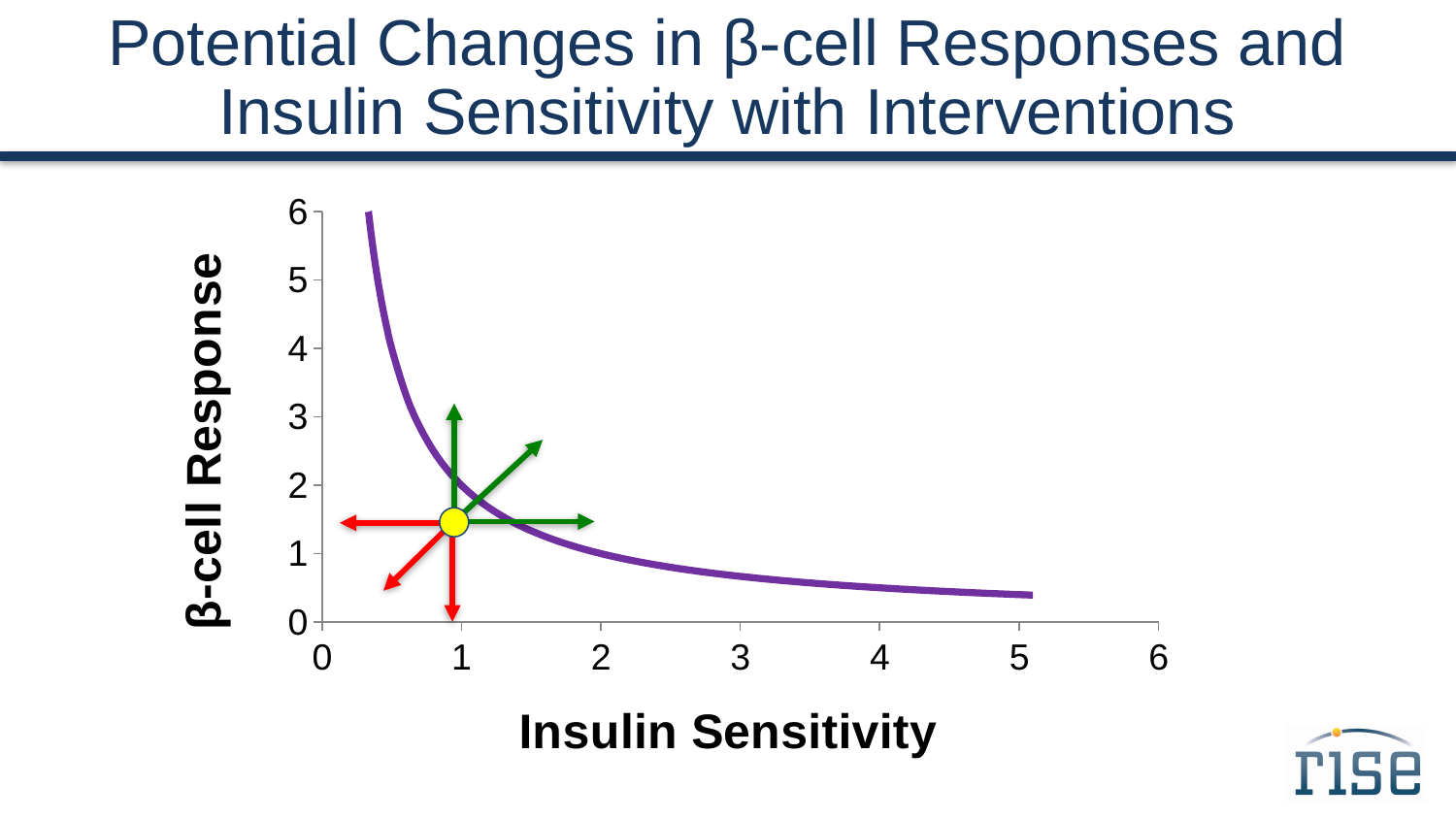
What colour is the curve plotted on the chart? purple Does the β-cell Response curve rise or fall as Insulin Sensitivity increases? fall What is the highest value shown on the x axis? 6 Is the β-cell Response on the curve at an Insulin Sensitivity of 5 greater or less than 1? less How many arrows point away from the yellow dot on the chart? 6 Is the β-cell Response on the curve at an Insulin Sensitivity of 0.5 greater or less than 3? greater What kind of chart is shown on the slide? line chart Is the β-cell Response on the curve at an Insulin Sensitivity of 4 greater or less than 2? less What is the highest value shown on the y axis? 6 What is the label of the y axis? β-cell Response What is the label of the x axis? Insulin Sensitivity